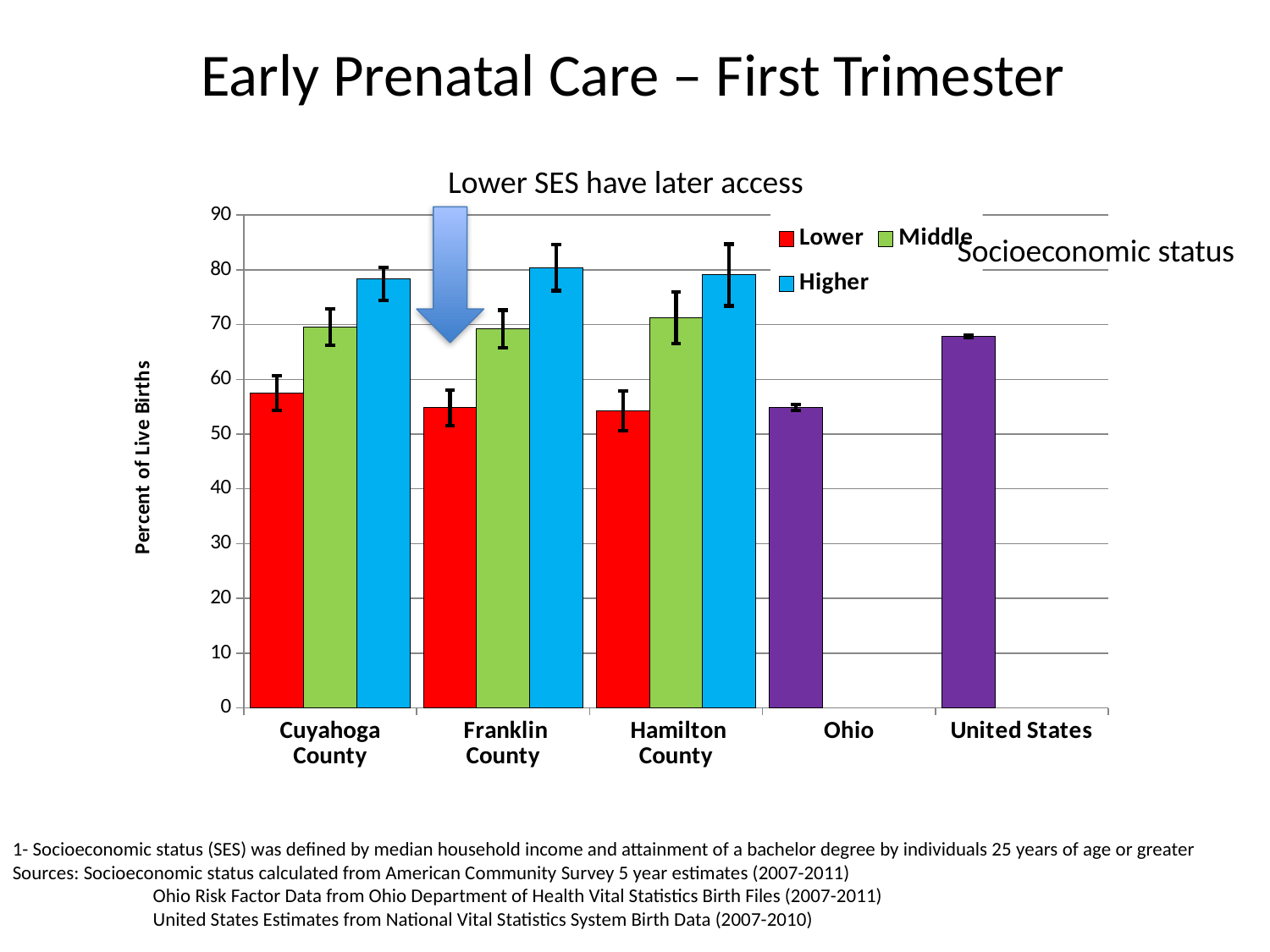
Is the value for the United States greater or less than 60? greater In Cuyahoga County, which SES group has the lowest value? Lower What kind of chart is shown on the slide? bar chart Is the value for Ohio greater or less than 60? less Which is larger, the value for Ohio or the value for the United States? United States Is the value for the Higher SES group in Cuyahoga County greater or less than 70? greater How many series does the legend list? 3 What is the title of the y axis? Percent of Live Births In Franklin County, which SES group has the highest value? Higher How many categories are shown along the x axis? 5